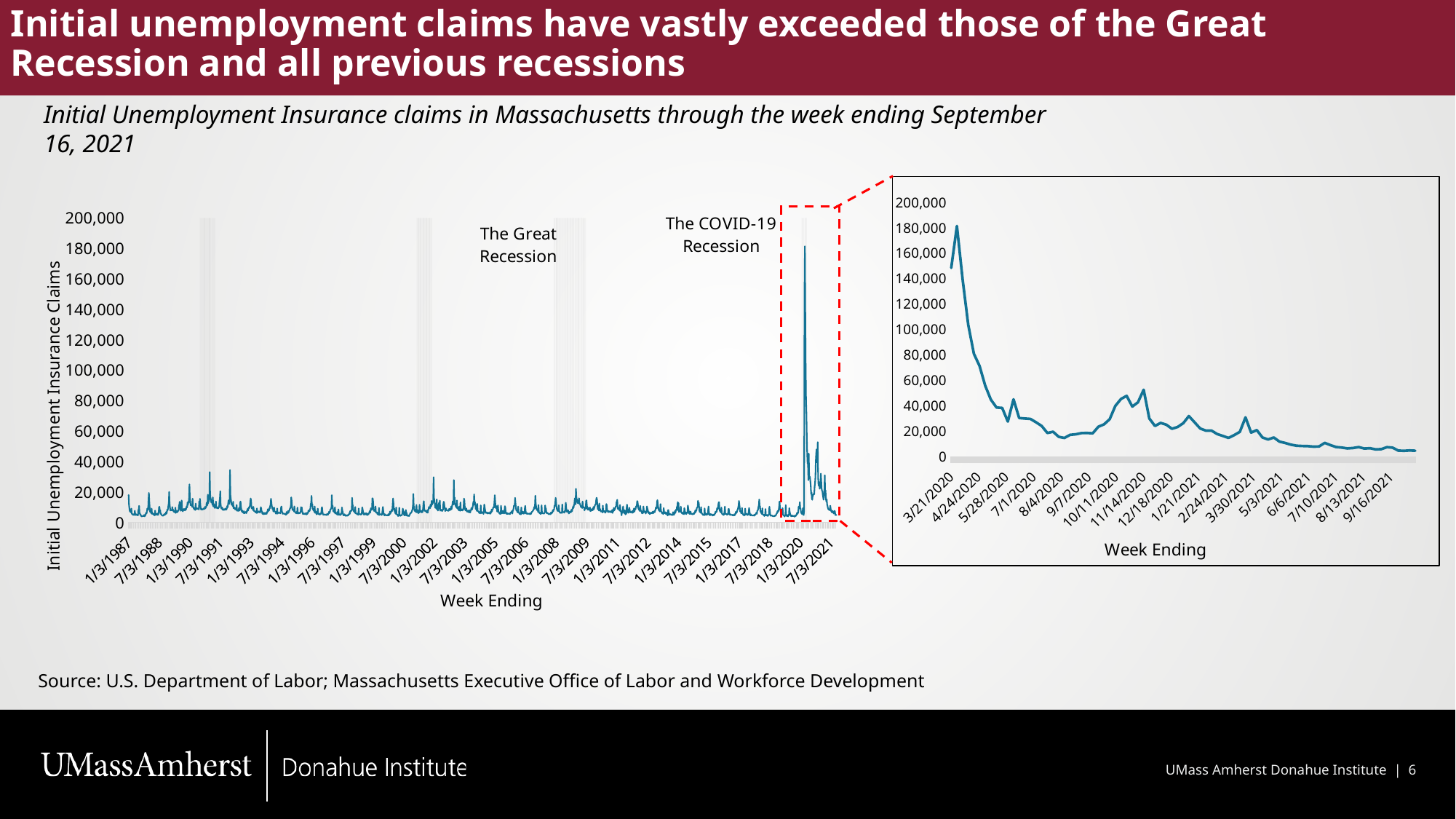
On the inset chart on the right, is the value for the week ending 11/14/2020 greater or less than 20,000? greater On the inset chart on the right, do the values generally rise or fall from 3/21/2020 to 9/16/2021? Fall What is the label on the vertical axis of the main chart on the left? Initial Unemployment Insurance Claims What kind of chart is the inset chart on the right of the slide? Line chart On the inset chart on the right, is the value for the week ending 9/16/2021 greater or less than 20,000? less What kind of chart is the main chart on the left of the slide? Line chart On the main chart on the left, is the peak value during the Great Recession greater or less than 60,000? less On the main chart on the left, which labelled recession shows the higher peak in initial claims, the Great Recession or the COVID-19 Recession? The COVID-19 Recession What is the label on the horizontal axis of the inset chart on the right? Week Ending